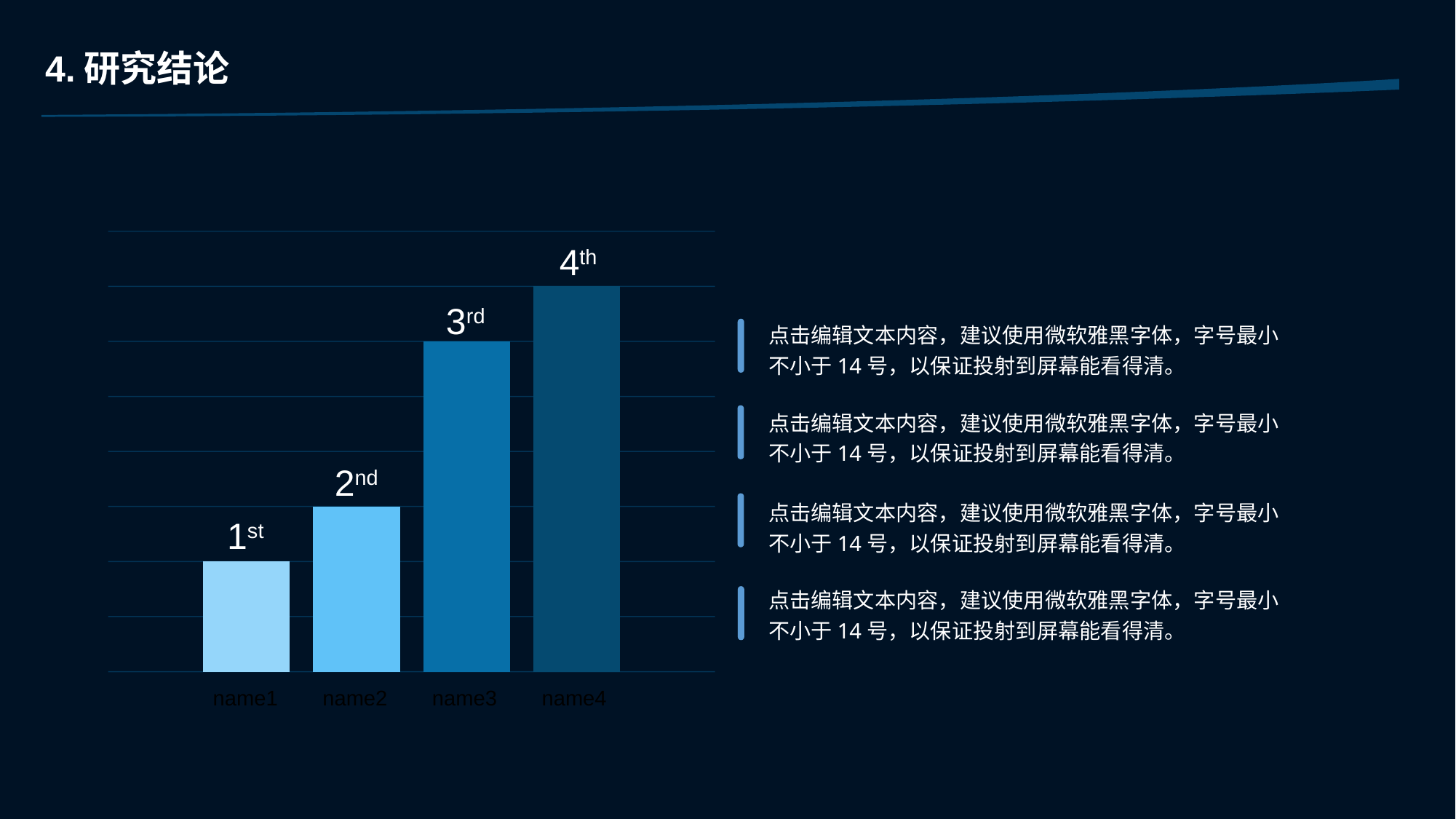
What label is printed above the bar for name1? 1st Which bar is taller, name2 or name3? name3 Do the bar heights rise or fall from name1 to name4? rise Which category has the shortest bar? name1 What label is printed above the bar for name3? 3rd Does the chart show a legend? No How many bars are plotted in the chart? 4 Which bar is taller, name1 or name4? name4 Which category has the tallest bar? name4 Which category's bar is labelled "4th"? name4 What is the label of the second category on the x axis? name2 What kind of chart is shown on the slide? bar chart